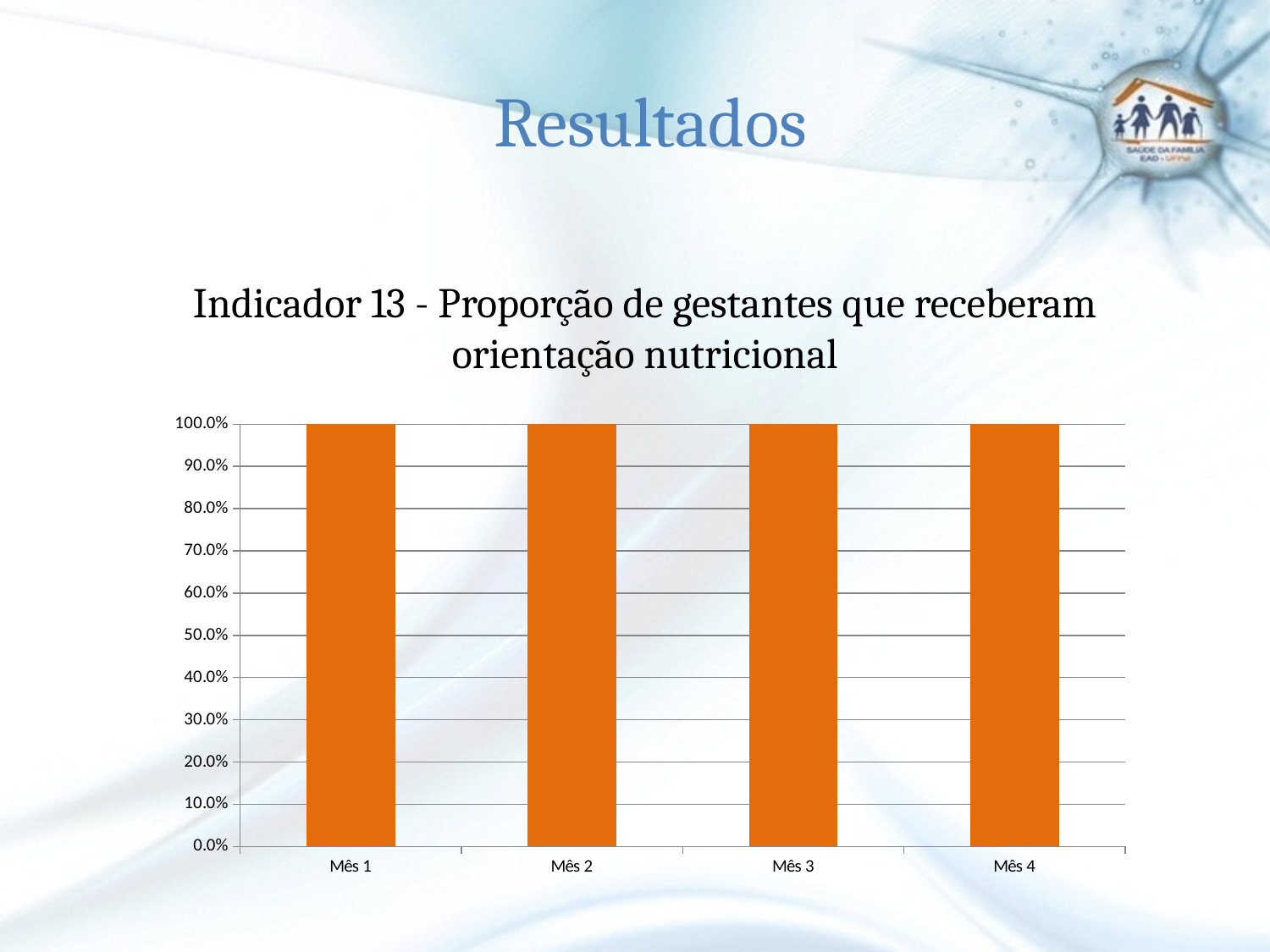
What is the value for Mês 3? 100.0% How many categories (months) are plotted on the chart? 4 What is the value for Mês 1? 100.0% What is the value for Mês 2? 100.0% What is the value for Mês 4? 100.0% What is the title of the chart? Indicador 13 - Proporção de gestantes que receberam orientação nutricional Do the values rise, fall, or stay the same from Mês 1 to Mês 4? stay the same Is the value for Mês 1 greater or less than 90.0%? greater What kind of chart is shown on the slide? bar chart What colour are the bars in the chart? orange Is the value for Mês 3 greater or less than 50.0%? greater What is the difference between the values for Mês 1 and Mês 4? 0.0%